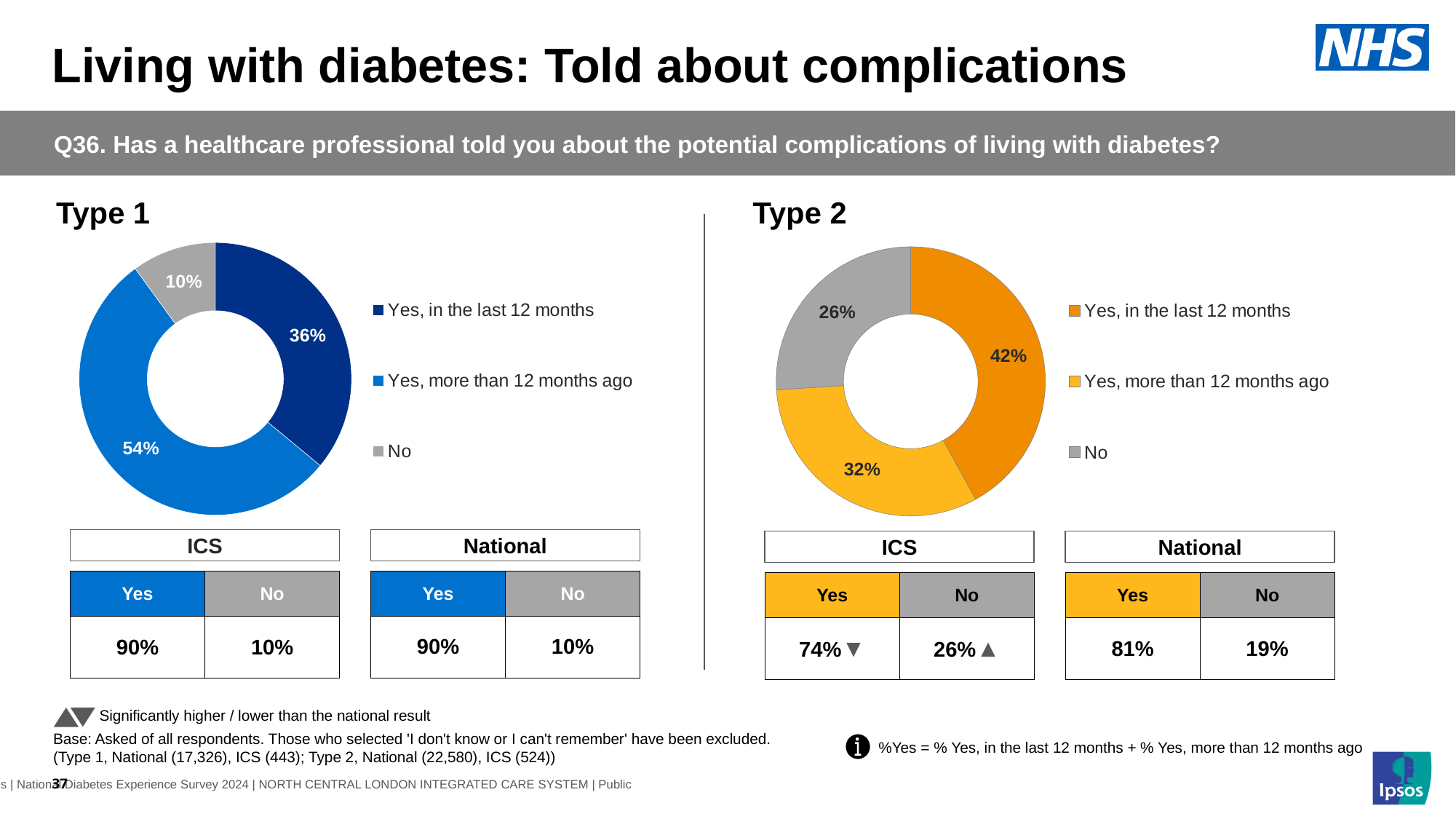
How many categories does the Type 2 chart show? 3 What is the third legend entry in the Type 2 chart? No In the Type 2 chart, what is the difference between 'Yes, in the last 12 months' and 'Yes, more than 12 months ago'? 10% In the Type 2 chart, what percentage answered 'Yes, in the last 12 months'? 42% What kind of chart is used for Type 1? Doughnut chart Which is larger in the Type 1 chart: 'Yes, in the last 12 months' or 'No'? Yes, in the last 12 months In the Type 1 chart, which response has the largest share? Yes, more than 12 months ago In the Type 1 chart, what is the combined share of the two 'Yes' responses? 90% In the Type 2 chart, which response has the smallest share? No In the Type 1 chart, what percentage answered 'Yes, more than 12 months ago'? 54% In the Type 1 chart, what percentage answered 'Yes, in the last 12 months'? 36% In the Type 2 chart, what percentage answered 'No'? 26%